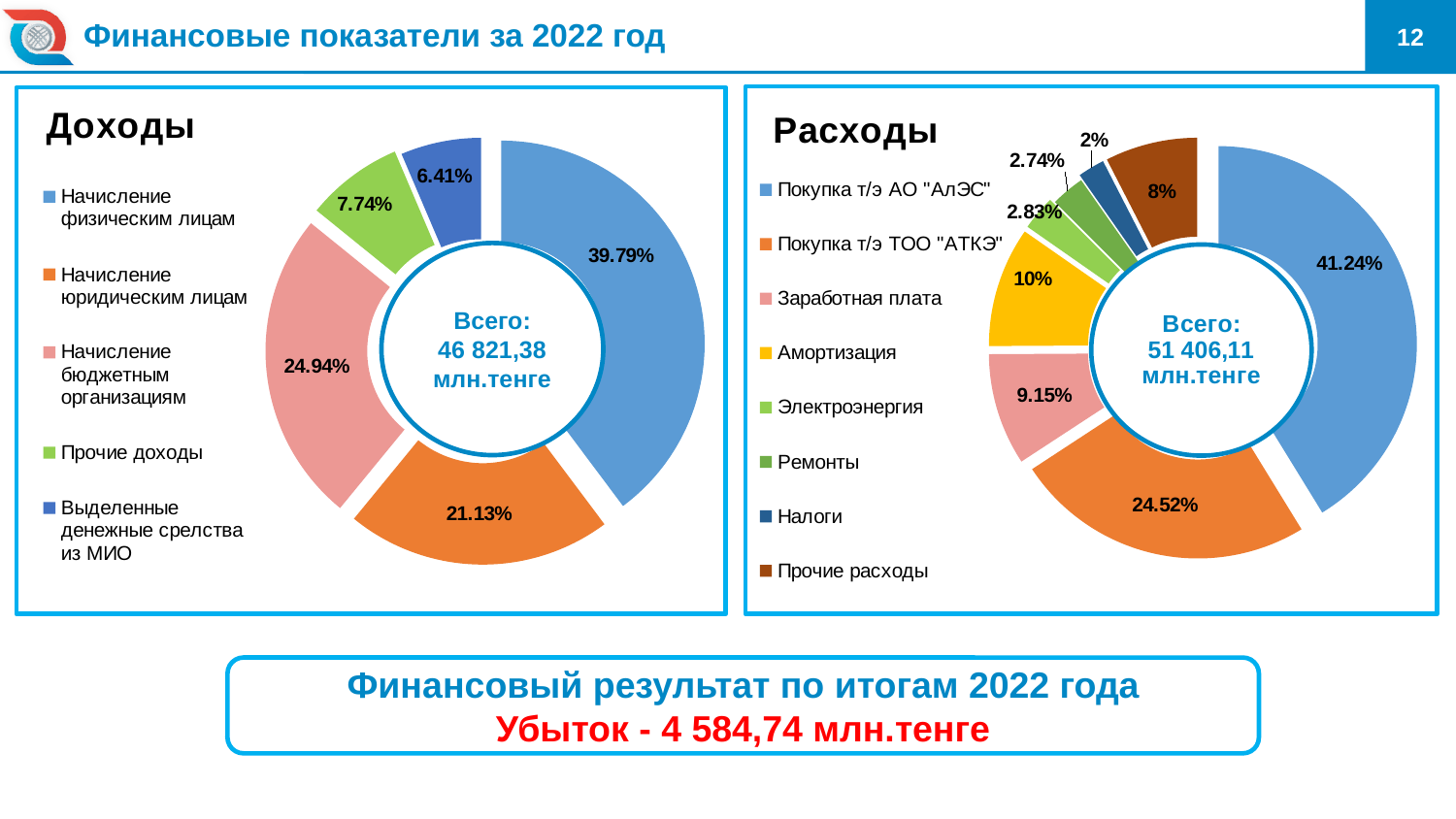
In the Доходы chart, which category has the largest share? Начисление физическим лицам In the Доходы chart, what share is labelled for Начисление физическим лицам? 39.79% What total is shown in the centre of the Расходы chart? 51 406,11 млн.тенге In the Расходы chart, what share is labelled for Заработная плата? 9.15% In the Доходы chart, which category has the smallest share? Выделенные денежные срелства из МИО In the Расходы chart, which category has the largest share? Покупка т/э АО "АлЭС" In the Доходы chart, what is the difference between the shares for Начисление бюджетным организациям and Начисление юридическим лицам? 3.81% In the Расходы chart, how many categories does the legend list? 8 In the Расходы chart, which is larger: the share for Амортизация or the share for Прочие расходы? Амортизация In the Доходы chart, what share is labelled for Начисление бюджетным организациям? 24.94% In the Расходы chart, what share is labelled for Покупка т/э ТОО "АТКЭ"? 24.52% In the Доходы chart, how many categories does the legend list? 5